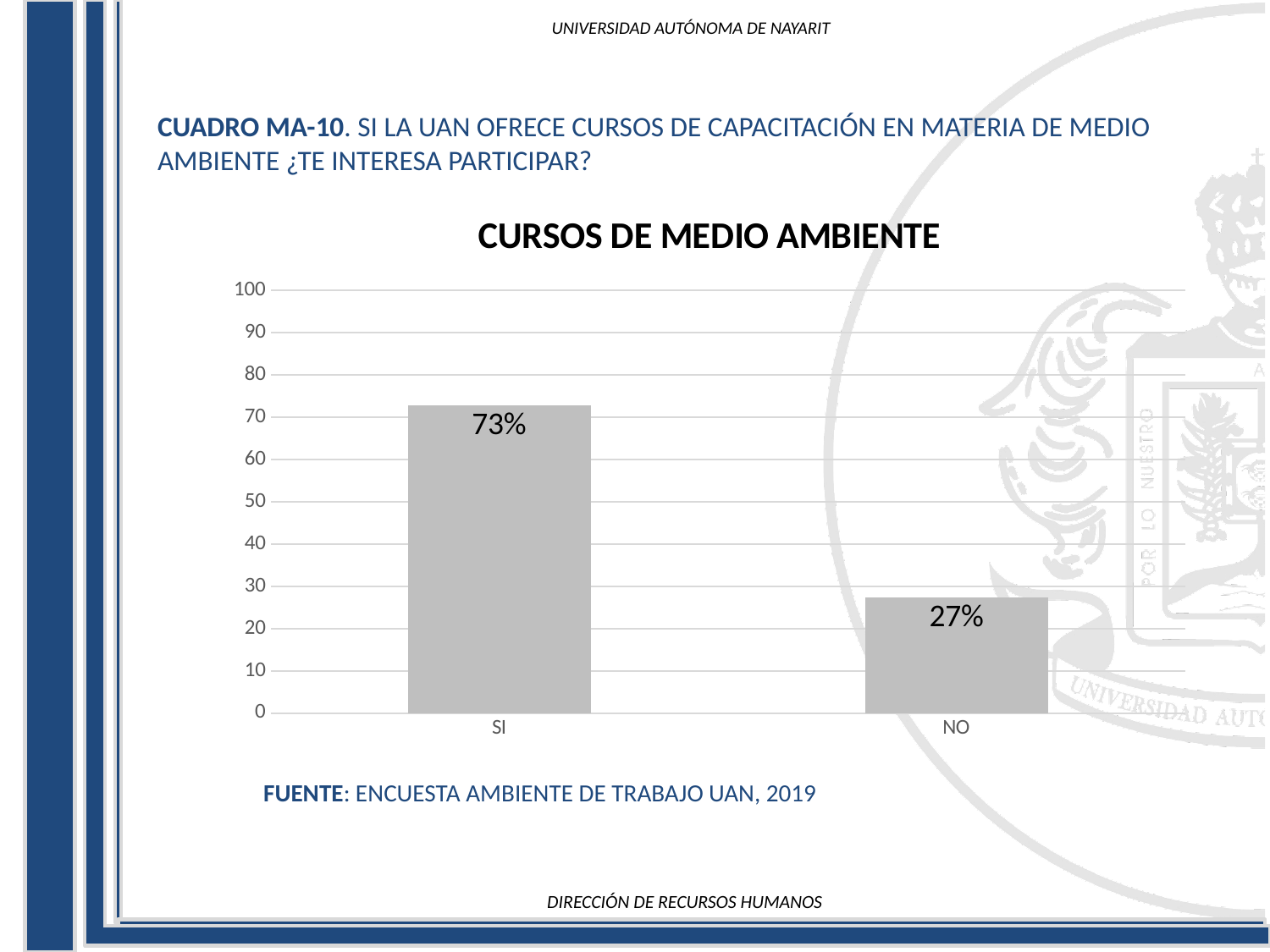
Is the value for SI greater or less than 70? greater What is the value for NO in the chart? 27% What is the maximum value shown on the y axis? 100 How many categories are shown on the x axis? 2 What is the value for SI in the chart? 73% Which is larger, the value for SI or the value for NO? SI Is the value for NO greater or less than 30? less Which category has the highest value? SI What is the difference between the values for SI and NO? 46% What kind of chart is shown on the slide? bar chart Which category has the lowest value? NO What is the title of the chart? CURSOS DE MEDIO AMBIENTE